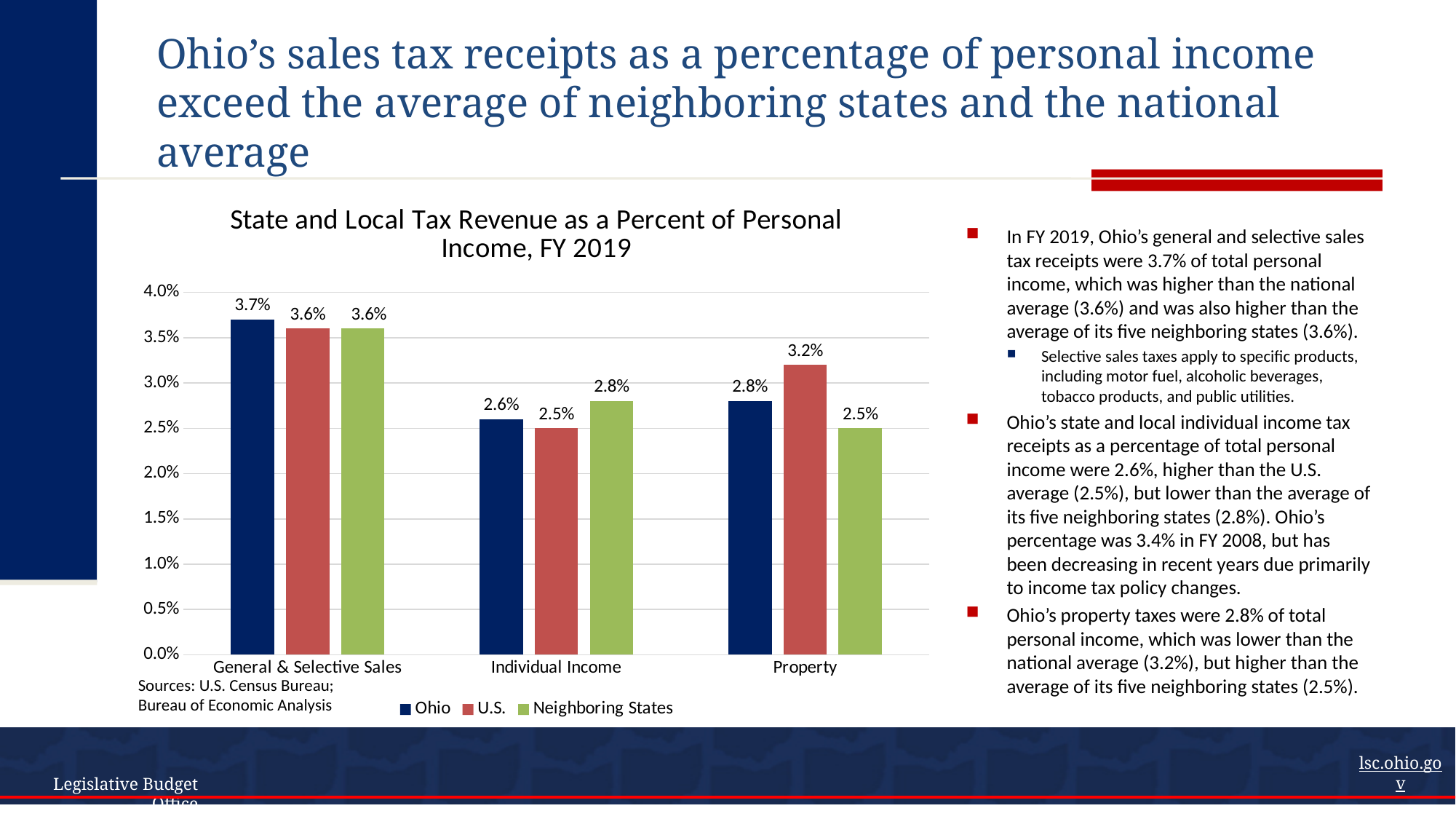
What kind of chart is shown? bar chart What is the Neighboring States value for Individual Income? 2.8% What is the difference between the U.S. value and the Ohio value for Property? 0.4% For Individual Income, which is larger: the Ohio value or the Neighboring States value? Neighboring States Which category has the lowest Neighboring States value? Property What is the U.S. value for Property? 3.2% What is the title of the chart? State and Local Tax Revenue as a Percent of Personal Income, FY 2019 Is the U.S. value for Individual Income greater or less than 3.0%? less How many series does the legend list? 3 How many categories are shown on the x axis? 3 Which category has the highest Ohio value? General & Selective Sales What is Ohio's value for General & Selective Sales? 3.7%